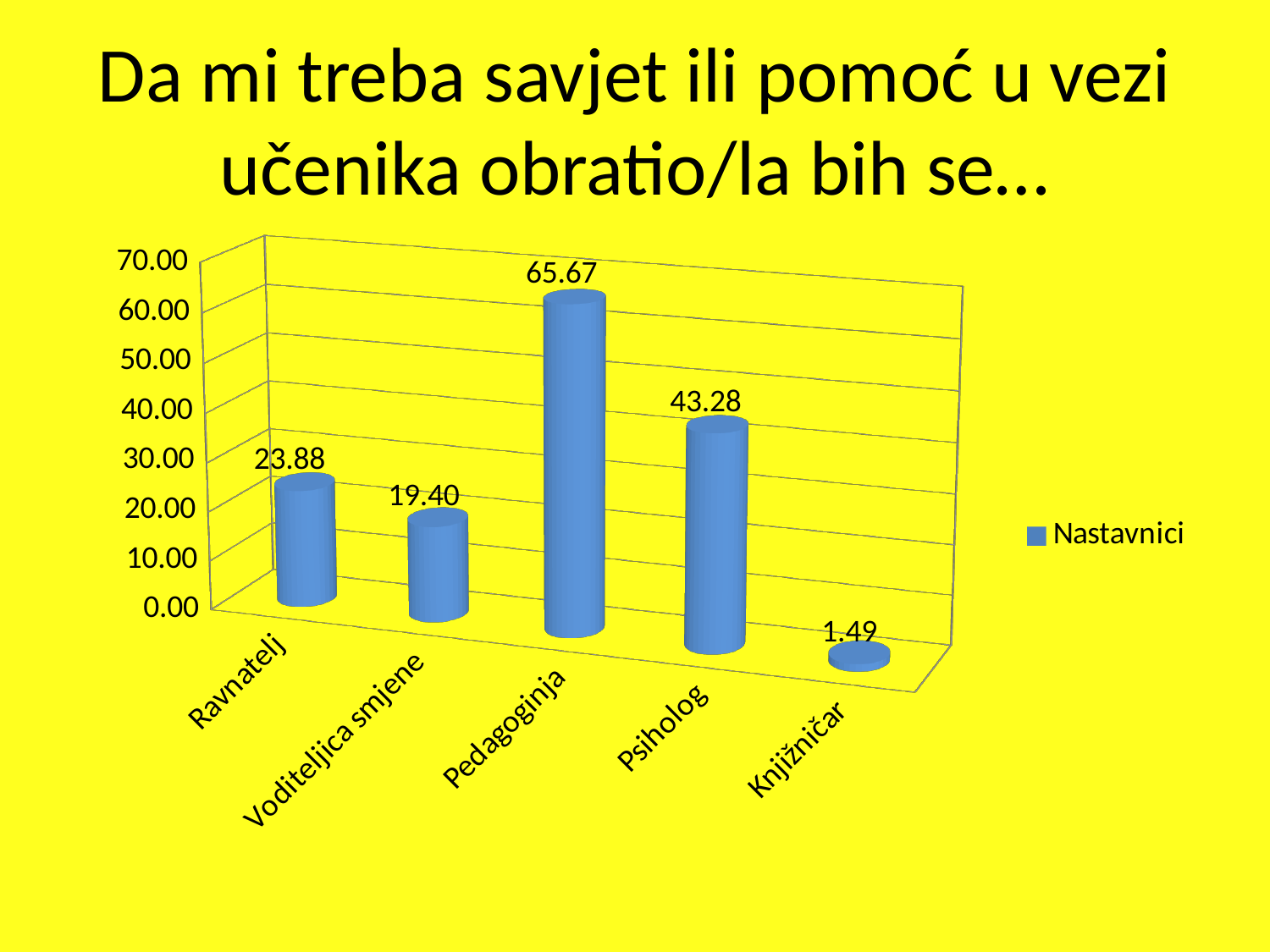
Which is larger, the value for Ravnatelj or the value for Voditeljica smjene? Ravnatelj What series name is listed in the legend? Nastavnici What is the value for Ravnatelj? 23.88 What is the value for Pedagoginja? 65.67 What is the value for Knjižničar? 1.49 What is the difference between the values for Pedagoginja and Psiholog? 22.39 Which category has the lowest value? Knjižničar What is the value for Psiholog? 43.28 Which category has the highest value? Pedagoginja How many categories are shown on the x axis? 5 Is the value for Psiholog greater or less than 40.00? greater What kind of chart is shown on the slide? bar chart